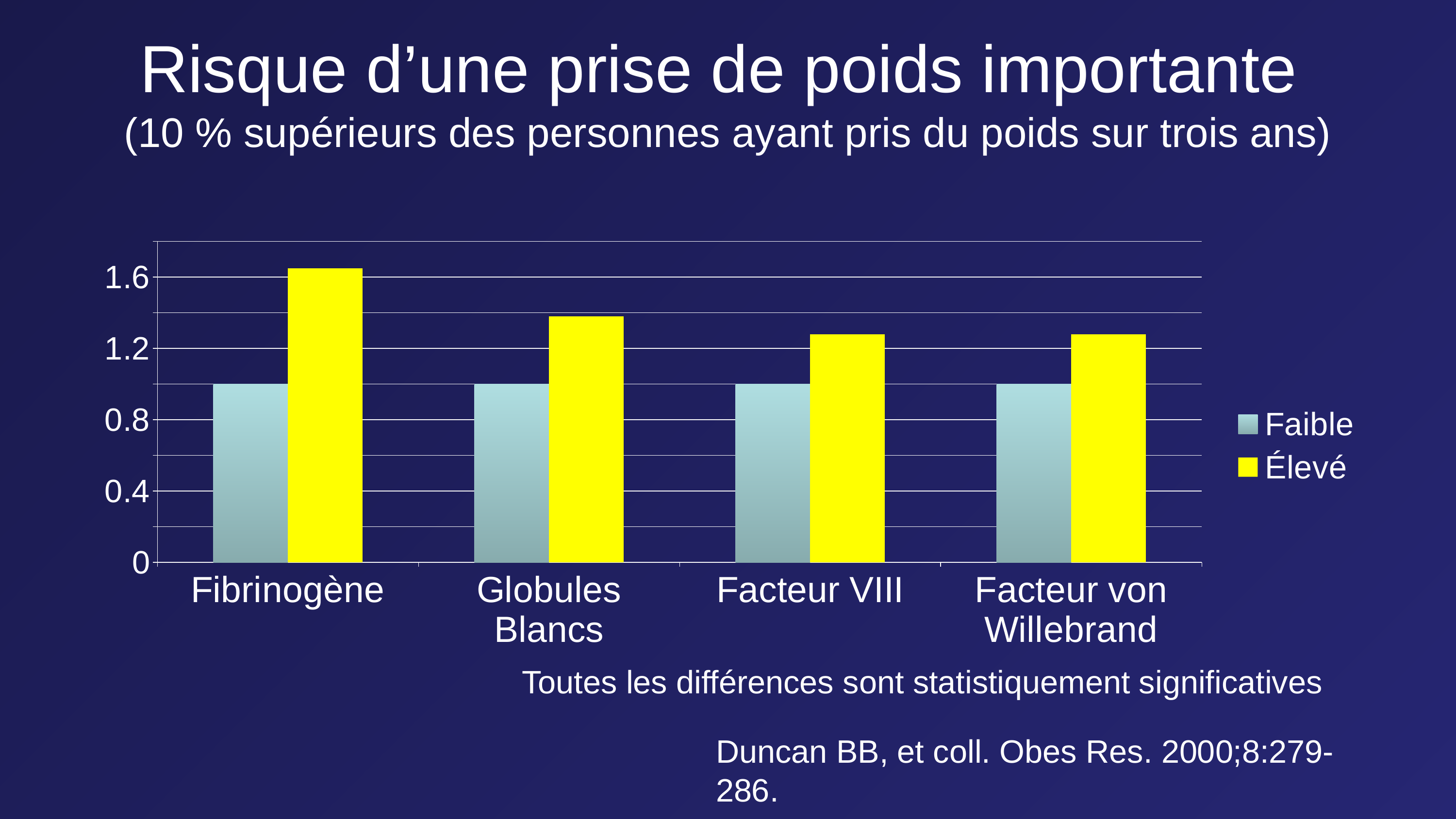
Is the Élevé value for Fibrinogène greater or less than 1.6? greater Which is larger, the Élevé value for Globules Blancs or the Élevé value for Facteur VIII? Globules Blancs What kind of chart is shown on the slide? bar chart What are the two entries in the chart's legend? Faible and Élevé How many series does the chart's legend list? 2 Is the Élevé value for Globules Blancs greater or less than 1.2? greater Is the Faible value for Facteur VIII greater or less than 1.2? less For Facteur VIII, which series has the larger value, Faible or Élevé? Élevé What colour are the Élevé bars in the chart? yellow Which category has the highest Élevé bar? Fibrinogène How many categories are shown on the x axis of the chart? 4